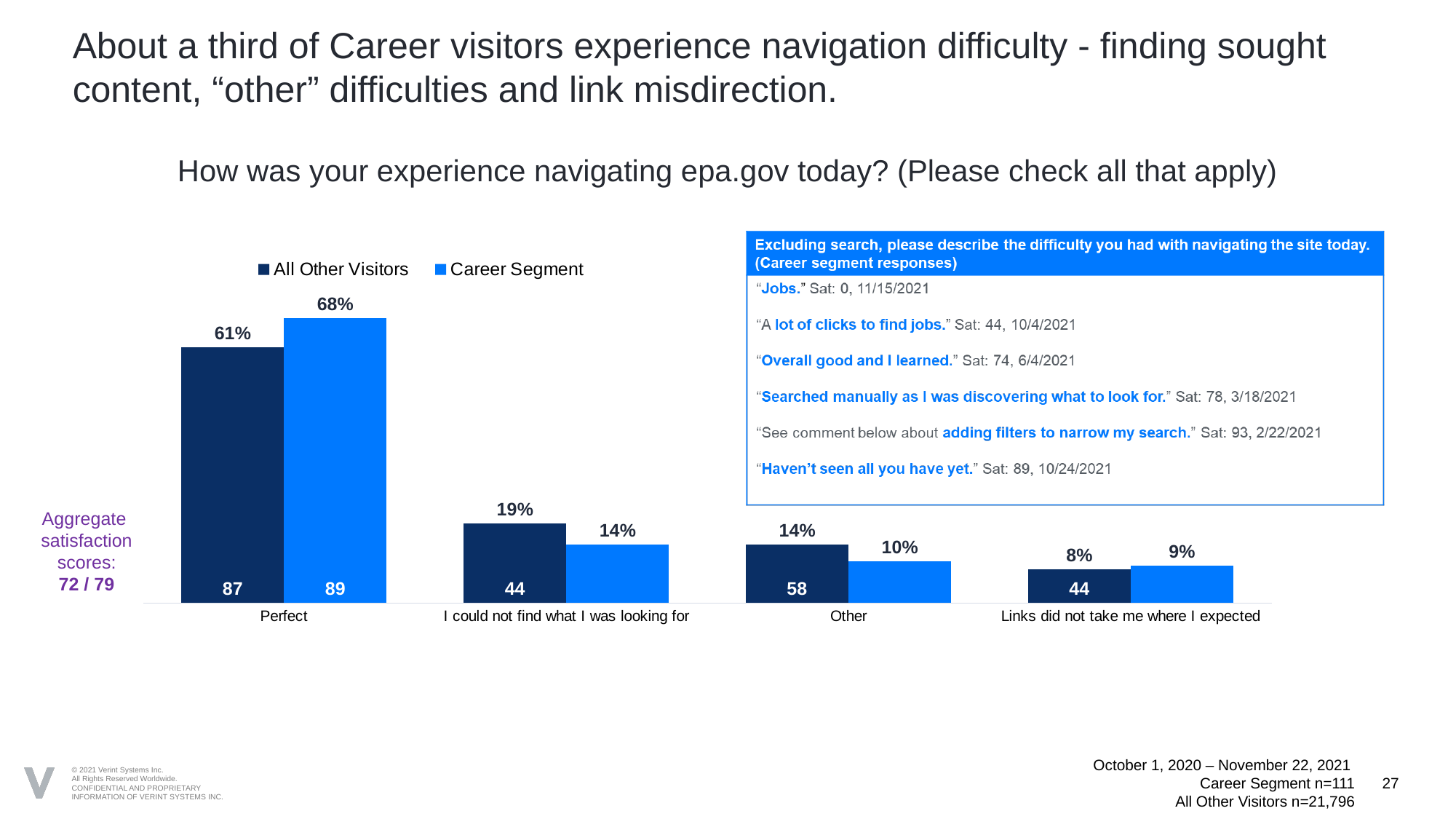
What is the difference between the Career Segment and All Other Visitors values for Perfect? 7% Which category has the lowest value for the Career Segment? Links did not take me where I expected What percentage of Career Segment visitors said their navigation experience was Perfect? 68% What percentage of All Other Visitors selected "I could not find what I was looking for"? 19% What are the two series named in the chart legend? All Other Visitors and Career Segment What satisfaction score is printed inside the All Other Visitors bar for "Other"? 58 How many series does the chart legend list? 2 Which category has the highest value for All Other Visitors? Perfect What type of chart is used on this slide? Bar chart How many categories are shown on the x axis of the chart? 4 What is the Career Segment value for "Links did not take me where I expected"? 9% For the "Other" category, which series has the larger value, All Other Visitors or Career Segment? All Other Visitors